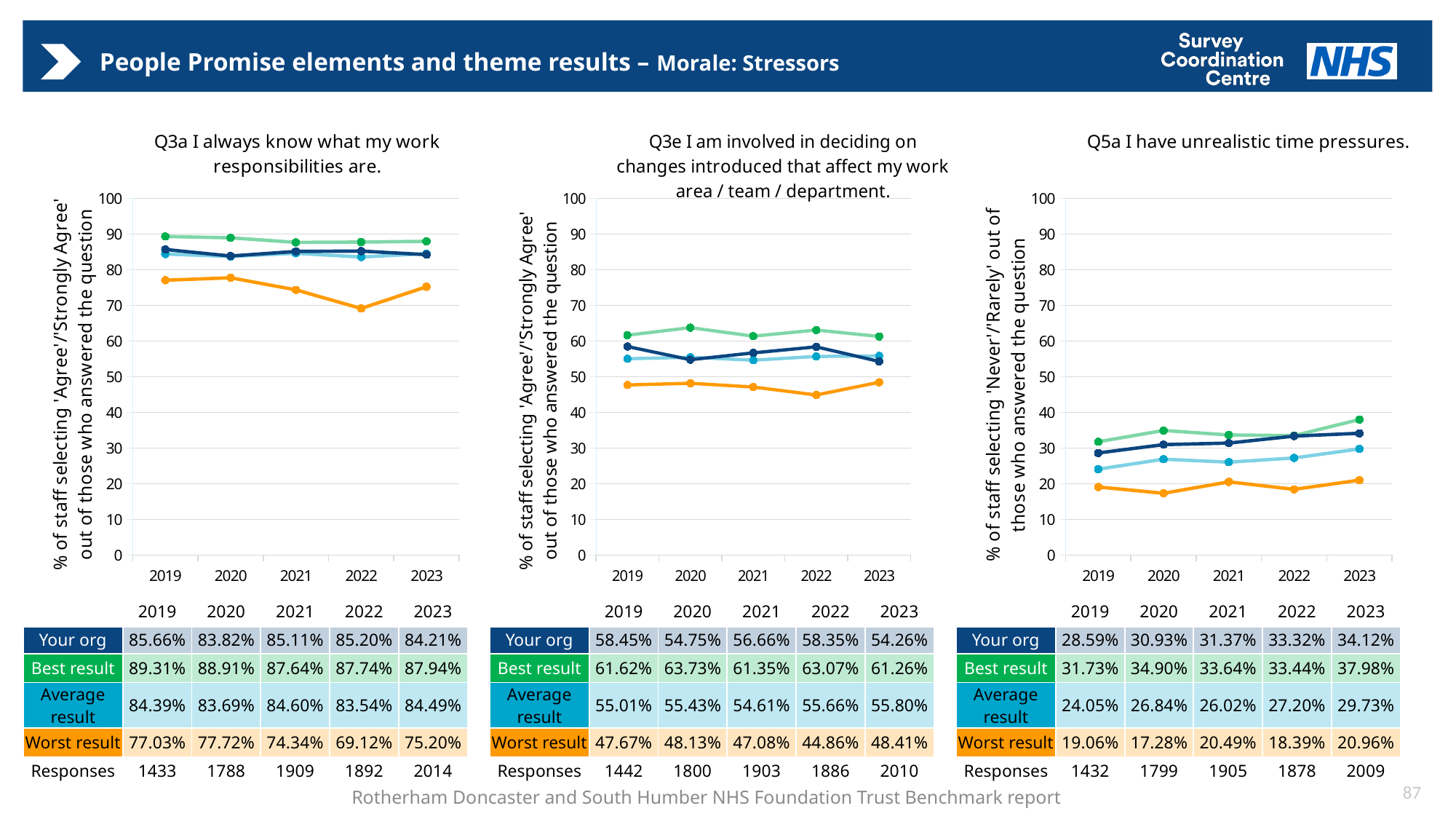
In the Q3a chart (I always know what my work responsibilities are), what is the 'Your org' value for 2022? 85.20% In the Q5a chart (I have unrealistic time pressures), does the 'Your org' line rise or fall from 2019 to 2023? rises In the Q3a chart, what is the difference between the 'Best result' and 'Your org' values in 2023? 3.73 percentage points In the Q3e chart, in which year is the 'Best result' value highest? 2020 In the Q3e chart, which year has the larger 'Your org' value, 2019 or 2022? 2019 In the Q3e chart (I am involved in deciding on changes), what is the 'Average result' value for 2021? 54.61% In the Q5a chart, is the 'Average result' value for 2019 greater or less than 30? less What type of chart is used for Q5a (I have unrealistic time pressures)? line chart In the Q3e chart, how many responses were recorded for 2023? 2010 In the Q3a chart, in which year is the 'Worst result' value lowest? 2022 In the Q5a chart, what is the 'Worst result' value for 2020? 17.28% How many years are plotted on the x axis of the Q3a chart? 5